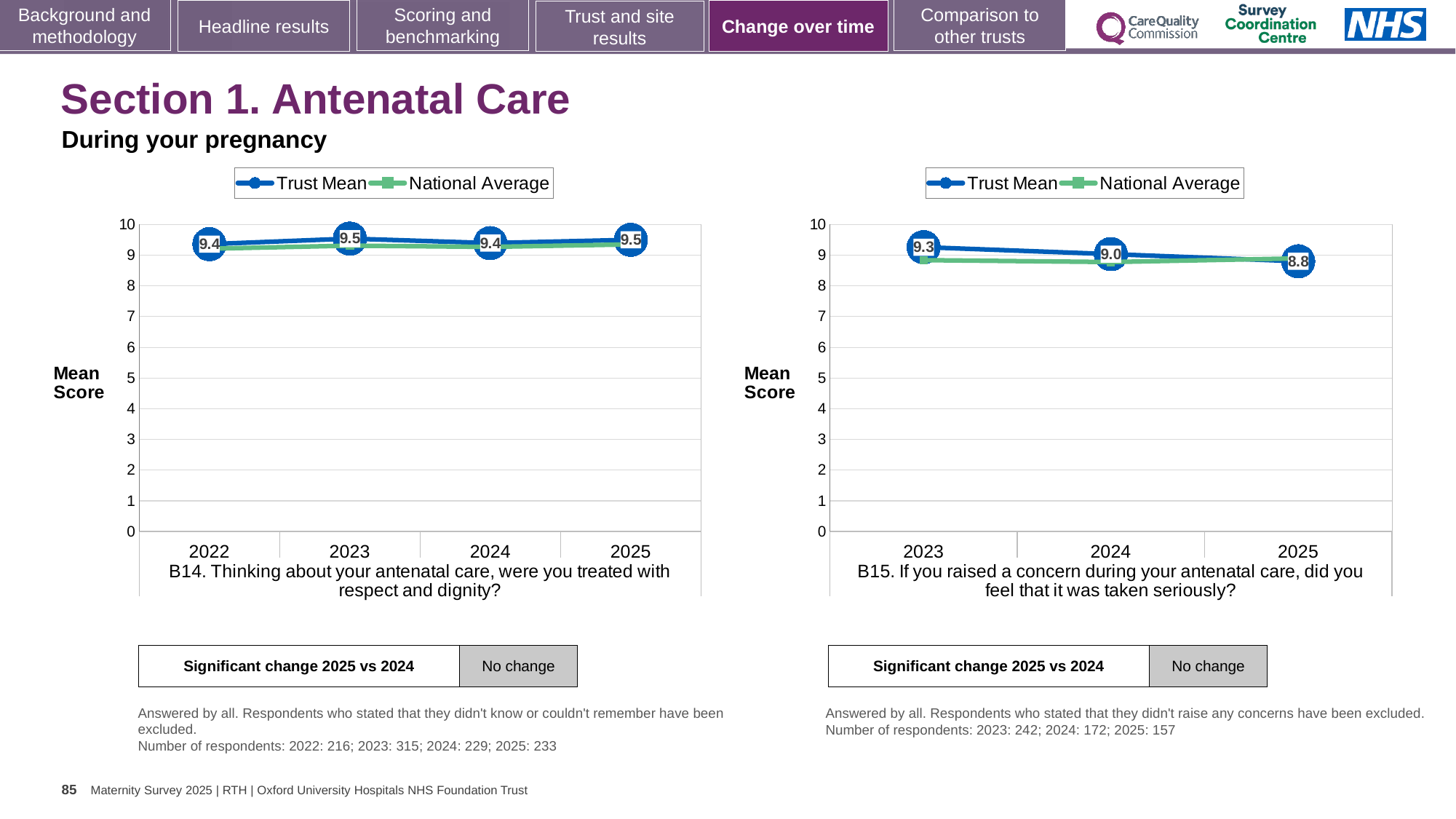
In the B15 chart on the right, which year has the lowest Trust Mean? 2025 In the B15 chart on the right, is the Trust Mean higher in 2023 or in 2025? 2023 In the B14 chart on the left, what is the Trust Mean for 2022? 9.4 How many years are shown on the x axis of the B14 chart on the left? 4 How many series does the legend of the B15 chart on the right list? 2 What type of chart is the B14 chart on the left? line chart In the B15 chart on the right, does the Trust Mean rise or fall from 2023 to 2025? fall In the B15 chart on the right, what is the difference between the Trust Mean for 2023 and 2025? 0.5 In the B14 chart on the left, is the National Average for 2022 greater or less than 8? greater In the B15 chart on the right, what is the Trust Mean for 2025? 8.8 In the B14 chart on the left, what is the Trust Mean for 2025? 9.5 In the B15 chart on the right, what is the Trust Mean for 2024? 9.0